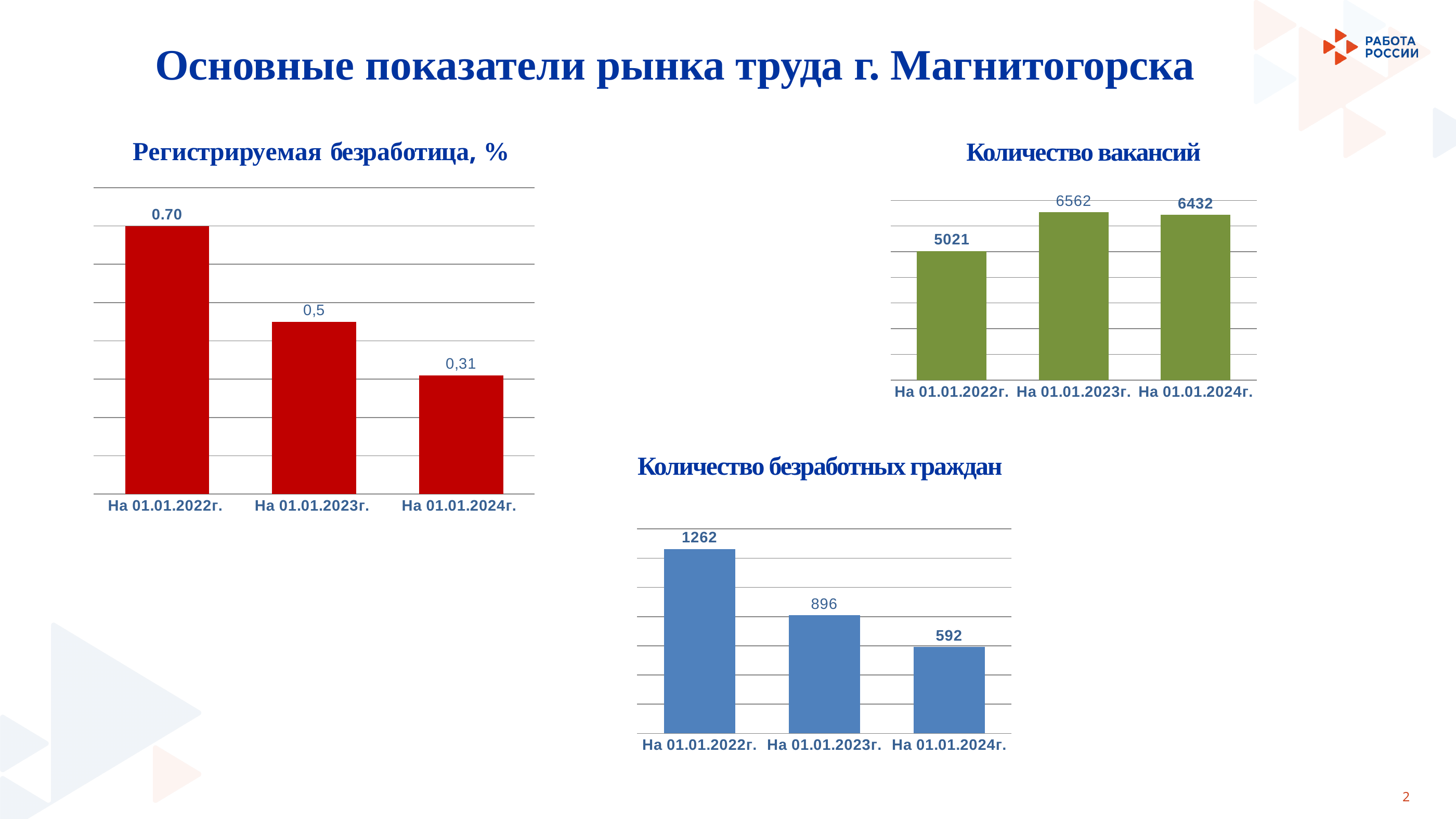
In the chart 'Количество вакансий', what is the value for На 01.01.2023г.? 6562 In the chart 'Количество безработных граждан', what is the value for На 01.01.2023г.? 896 What kind of chart is 'Количество вакансий'? bar chart In the chart 'Регистрируемая безработица, %', what is the value for На 01.01.2022г.? 0.70 In the chart 'Количество вакансий', which date has the lowest value? На 01.01.2022г. In the chart 'Количество вакансий', what is the difference between the values for На 01.01.2023г. and На 01.01.2022г.? 1541 In the chart 'Количество безработных граждан', which date has the highest value? На 01.01.2022г. In the chart 'Количество безработных граждан', which is larger: the value for На 01.01.2023г. or На 01.01.2024г.? На 01.01.2023г. In the chart 'Количество вакансий', how many bars are there? 3 In the chart 'Количество безработных граждан', what is the difference between the values for На 01.01.2022г. and На 01.01.2024г.? 670 In the chart 'Регистрируемая безработица, %', what is the value for На 01.01.2024г.? 0,31 In the chart 'Регистрируемая безработица, %', do the values rise or fall from На 01.01.2022г. to На 01.01.2024г.? fall